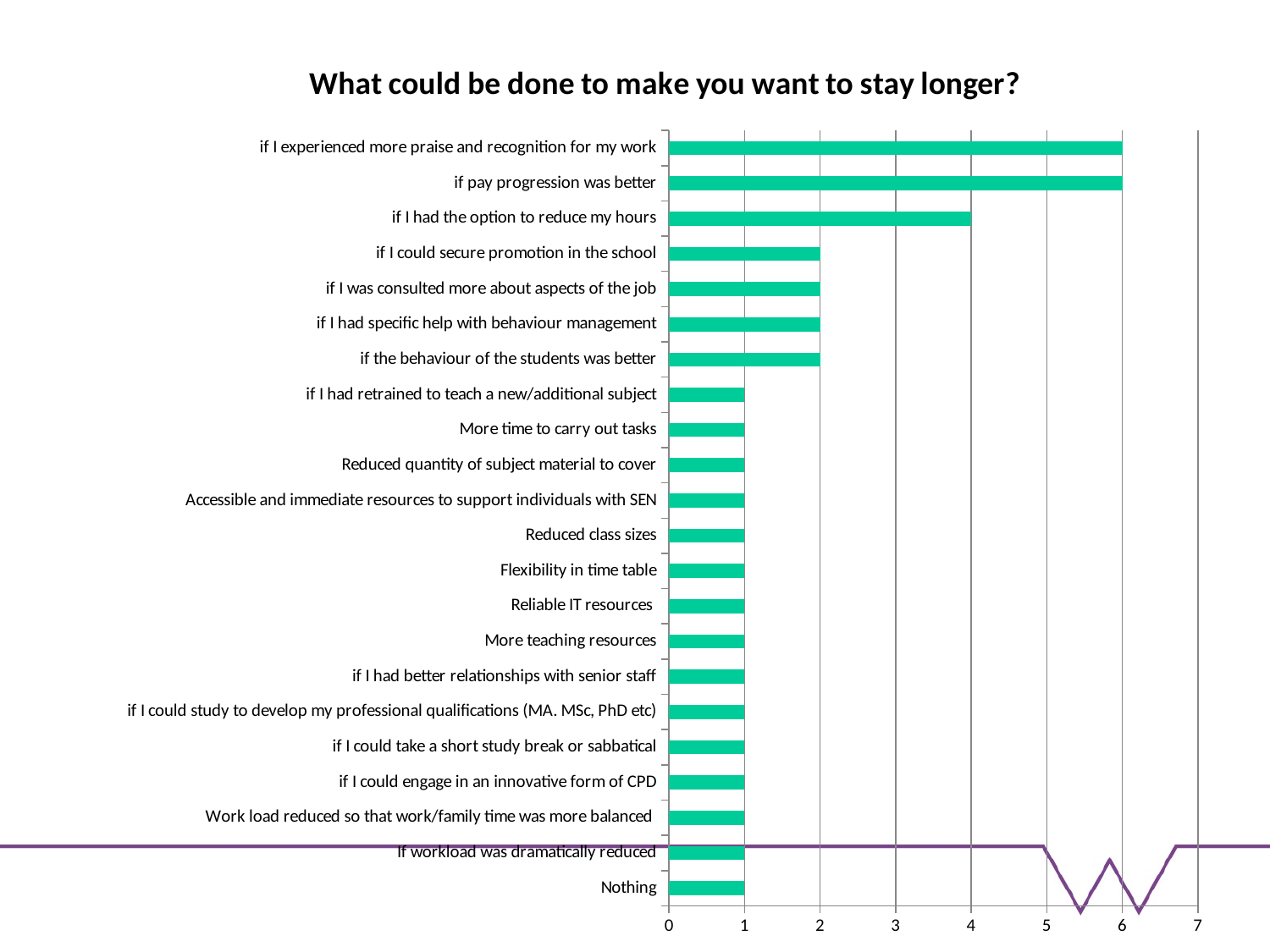
How many categories are shown on the chart? 22 Which is larger: the value for "if I could secure promotion in the school" or the value for "Reduced class sizes"? if I could secure promotion in the school What is the value for "if I experienced more praise and recognition for my work"? 6 What is the difference between the value for "if pay progression was better" and the value for "if I had the option to reduce my hours"? 2 What is the value for "if the behaviour of the students was better"? 2 What is the title of the chart? What could be done to make you want to stay longer? What is the value for "Nothing"? 1 What is the difference between the value for "if I was consulted more about aspects of the job" and the value for "Reliable IT resources"? 1 What is the value for "if pay progression was better"? 6 Is the value for "if I had the option to reduce my hours" greater or less than 3? greater What is the value for "if I had the option to reduce my hours"? 4 What type of chart is shown on the slide? bar chart